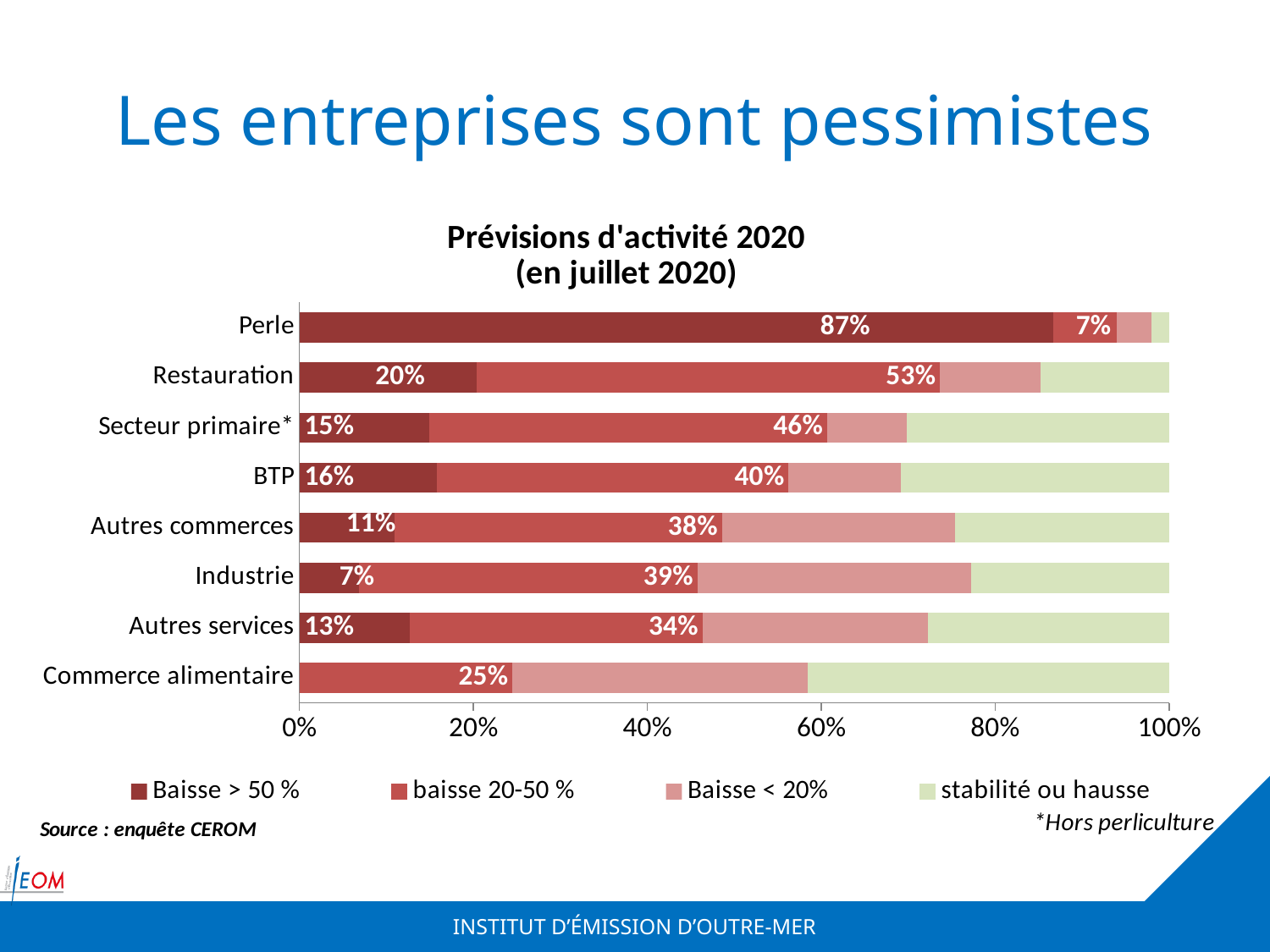
Which category has the highest value for 'Baisse > 50 %'? Perle What is the value of 'baisse 20-50 %' for Restauration? 53% Is the 'stabilité ou hausse' value for Restauration greater or less than 20%? less How many series does the legend list? 4 Which category has the lowest value for 'baisse 20-50 %'? Perle What is the difference between the 'baisse 20-50 %' values for Restauration and Perle? 46 percentage points How many categories are shown on the chart? 8 What is the value of 'Baisse > 50 %' for Perle? 87% What kind of chart is shown on the slide? Stacked bar chart What is the value of 'baisse 20-50 %' for Commerce alimentaire? 25% Which has a larger 'Baisse > 50 %' value, Restauration or BTP? Restauration What is the value of 'Baisse > 50 %' for Industrie? 7%